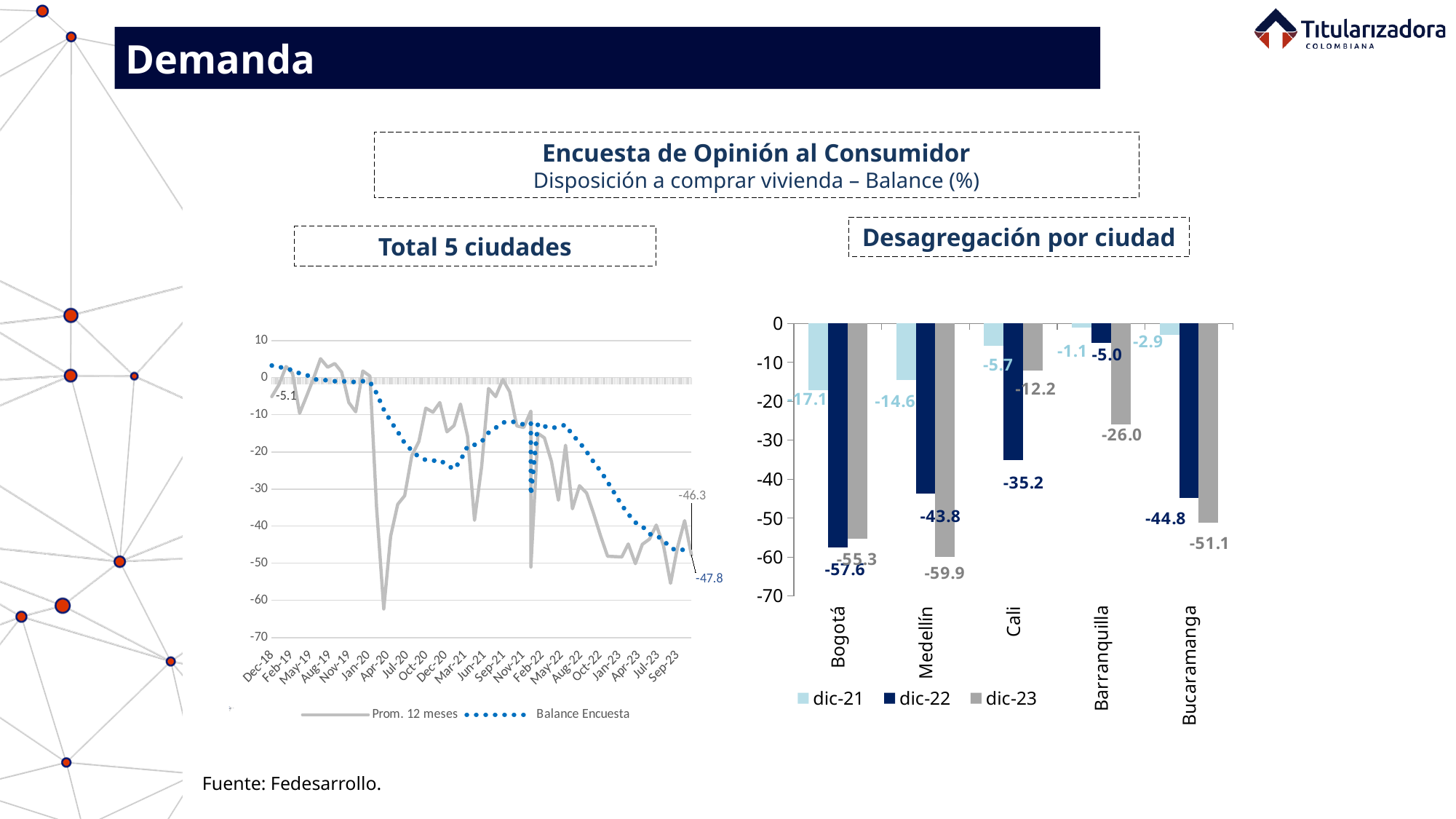
In the 'Desagregación por ciudad' chart, which is larger, the dic-23 value for Bucaramanga or the dic-23 value for Bogotá? Bucaramanga In the 'Desagregación por ciudad' chart, which city has the lowest dic-23 value? Medellín In the 'Total 5 ciudades' chart, what is the last labelled value of the Balance Encuesta series? -47.8 In the 'Desagregación por ciudad' chart, what is the dic-21 value for Barranquilla? -1.1 In the 'Desagregación por ciudad' chart, what is the dic-22 value for Bogotá? -57.6 In the 'Total 5 ciudades' chart, does the Balance Encuesta series rise or fall between Feb-22 and Sep-23? Fall In the 'Desagregación por ciudad' chart, which city has the highest dic-22 value? Barranquilla In the 'Desagregación por ciudad' chart, what is the difference between the dic-23 and dic-22 values for Cali? 23.0 In the 'Desagregación por ciudad' chart, what is the dic-23 value for Medellín? -59.9 What kind of chart is the 'Total 5 ciudades' chart? Line chart How many cities are shown in the 'Desagregación por ciudad' chart? 5 How many series does the legend of the 'Desagregación por ciudad' chart list? 3